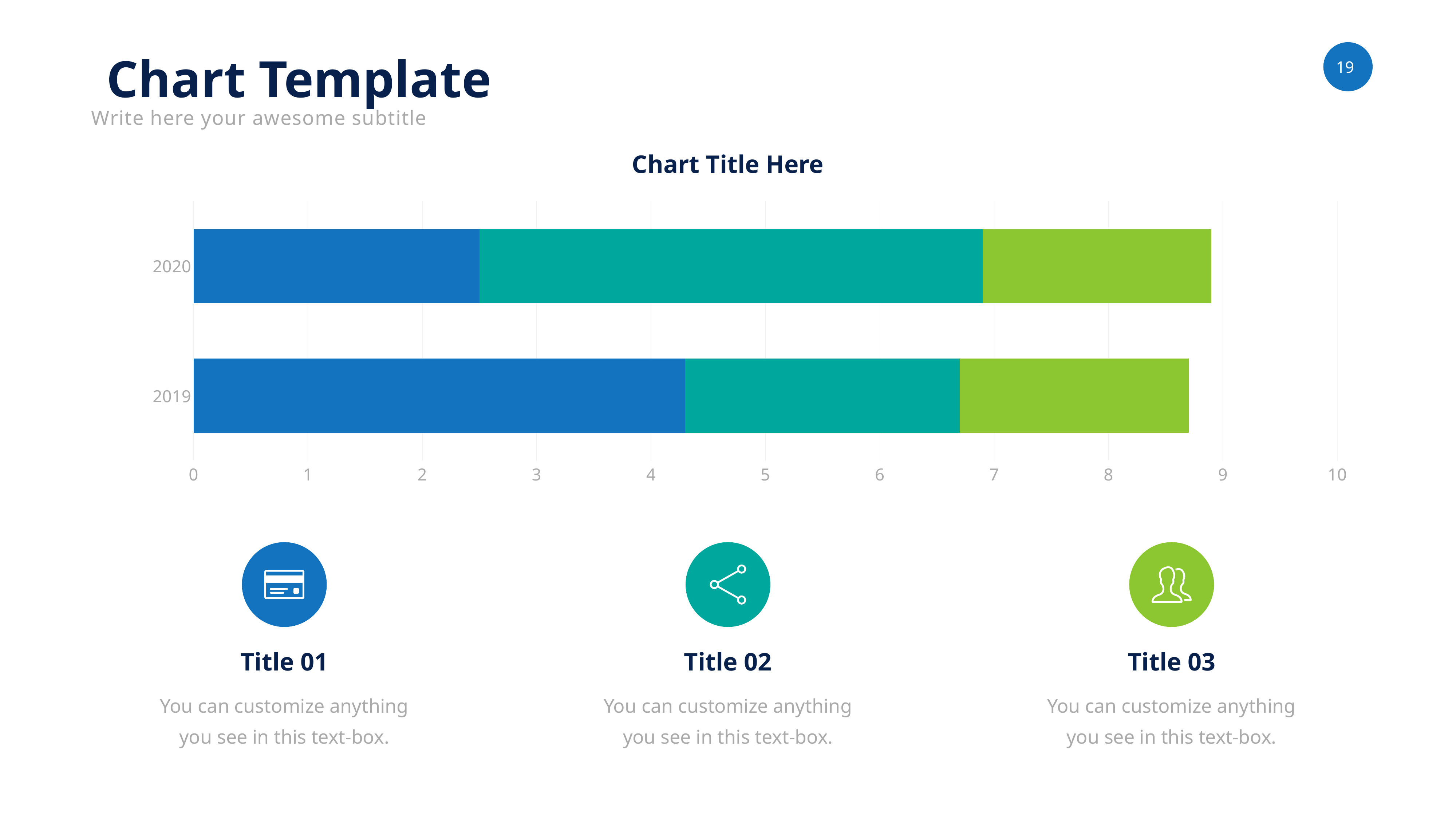
Is the value of the blue segment for 2019 greater or less than 4? greater Is the teal segment larger for 2019 or for 2020? 2020 How many coloured segments make up each bar in the chart? 3 How many categories (years) are shown on the chart's vertical axis? 2 Is the total length of the 2020 bar greater or less than 8? greater Is the value of the blue segment for 2020 greater or less than 3? less Which years are shown as categories on the chart? 2019 and 2020 Is the blue segment larger for 2019 or for 2020? 2019 What is the title of the chart? Chart Title Here What is the maximum value shown on the chart's horizontal axis? 10 What type of chart is shown on the slide? Stacked bar chart